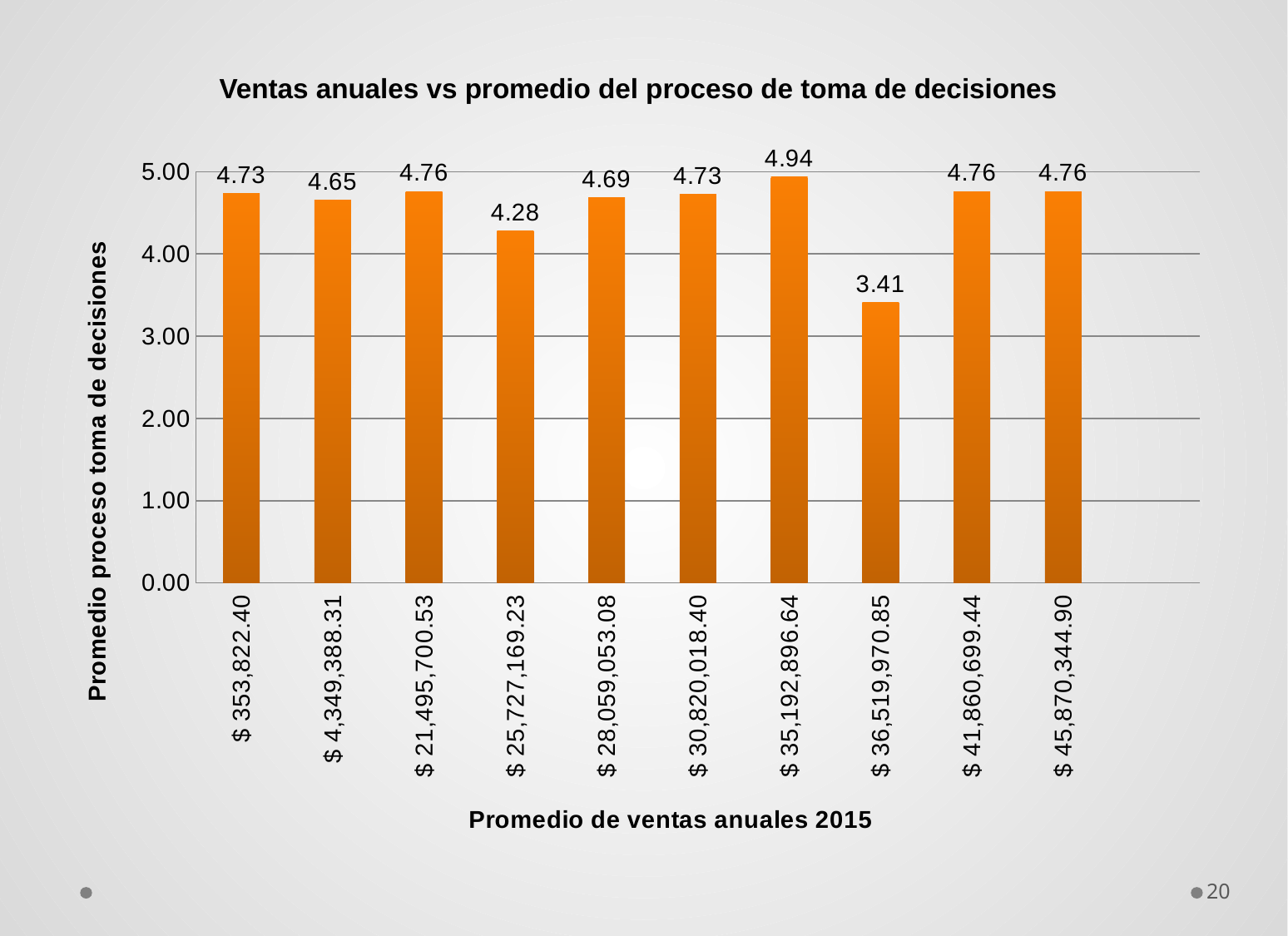
How many bars are shown in the chart? 10 What is the value for the category $ 25,727,169.23? 4.28 Which category has the highest value? $ 35,192,896.64 Which is larger, the value for $ 4,349,388.31 or the value for $ 21,495,700.53? $ 21,495,700.53 What is the value for the category $ 36,519,970.85? 3.41 What is the value for the category $ 353,822.40? 4.73 What is the title of the chart? Ventas anuales vs promedio del proceso de toma de decisiones Is the value for $ 36,519,970.85 greater or less than 4.00? less What is the difference between the values for $ 35,192,896.64 and $ 36,519,970.85? 1.53 What kind of chart is shown on the slide? bar chart Which category has the lowest value? $ 36,519,970.85 What is the label of the x axis? Promedio de ventas anuales 2015